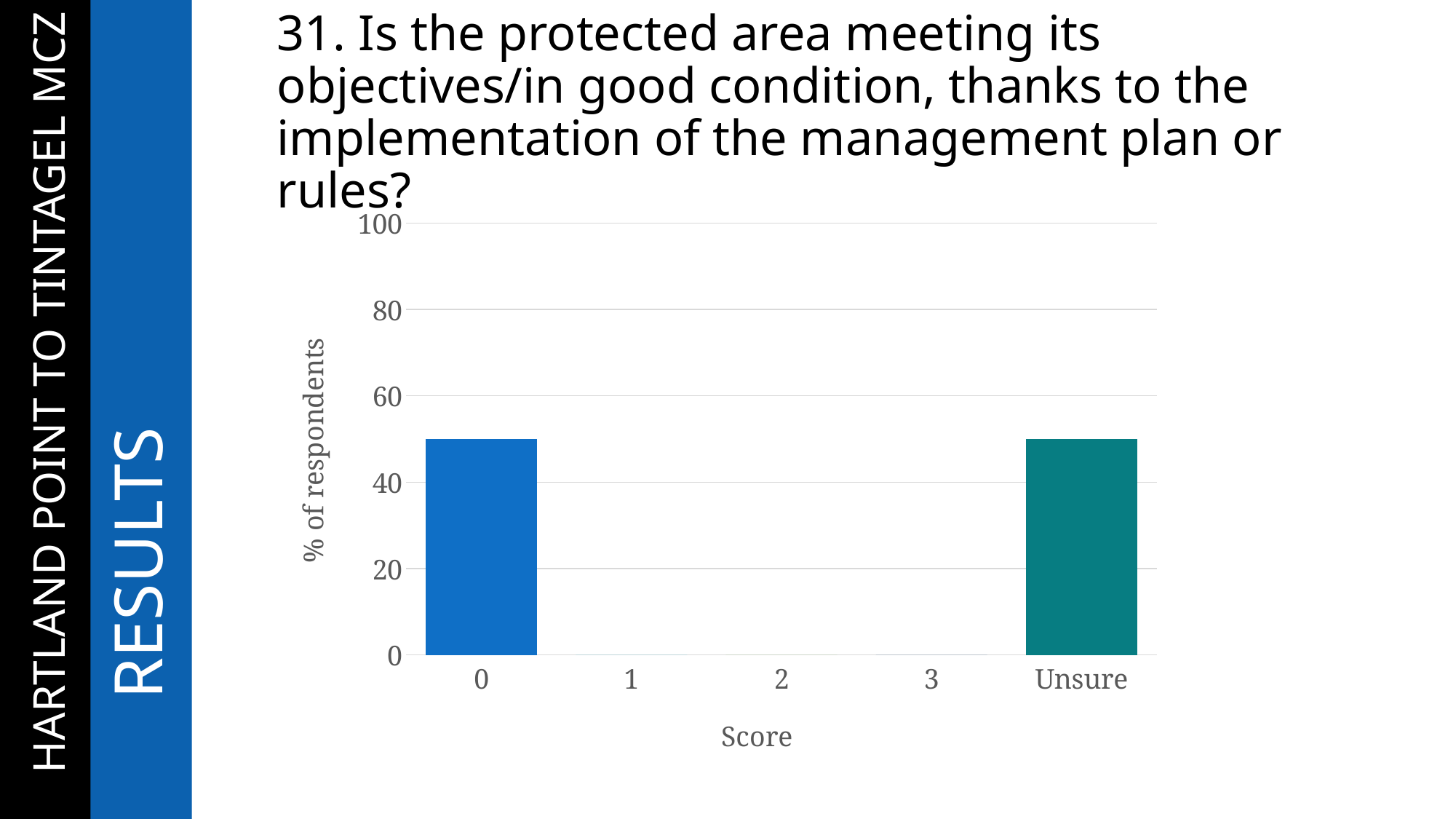
Is the value for Unsure greater or less than 40? greater Is the value for Unsure greater or less than 60? less How many categories are shown on the x axis of the chart? 5 What kind of chart is shown on the slide? bar chart Is the value for score 0 greater or less than 40? greater Which categories on the x axis have no visible bar? 1, 2 and 3 What is the label of the y axis? % of respondents Which is larger, the value for score 2 or the value for Unsure? Unsure What is the label of the x axis? Score Which is larger, the value for score 0 or the value for score 1? score 0